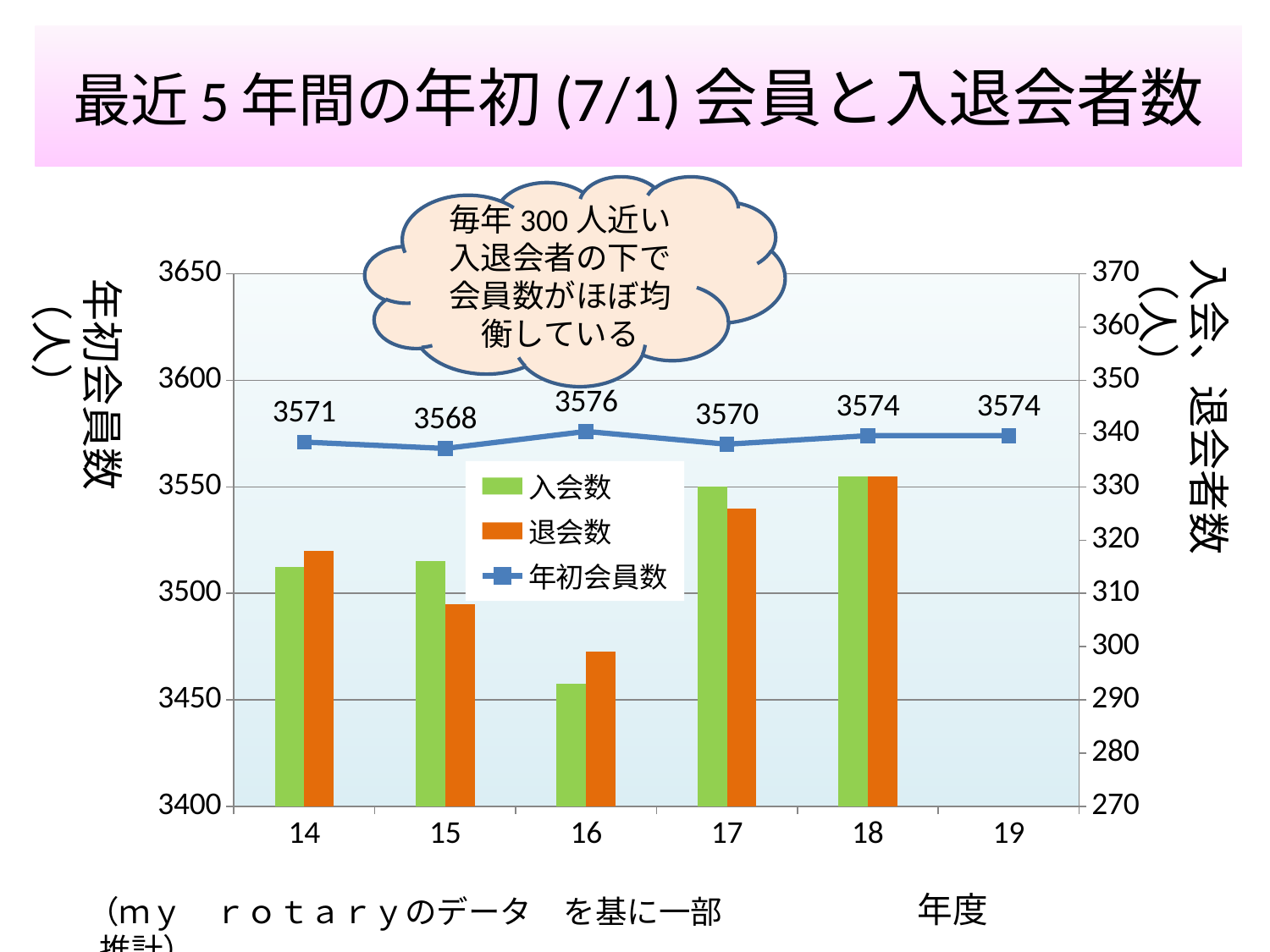
Which year has the lowest 入会数? 16 Which year has the lowest 年初会員数? 15 Which year has the highest 年初会員数? 16 For year 15, which is larger, 入会数 or 退会数? 入会数 What is the 年初会員数 value for year 15? 3568 How many series does the legend list? 3 For year 16, which is larger, 入会数 or 退会数? 退会数 Is the 退会数 for year 14 greater or less than 310? greater What is the 年初会員数 value for year 16? 3576 What is the difference between the 年初会員数 for year 16 and year 15? 8 Is the 入会数 for year 16 greater or less than 300? less What kind of chart is shown on the slide? A combined bar and line chart